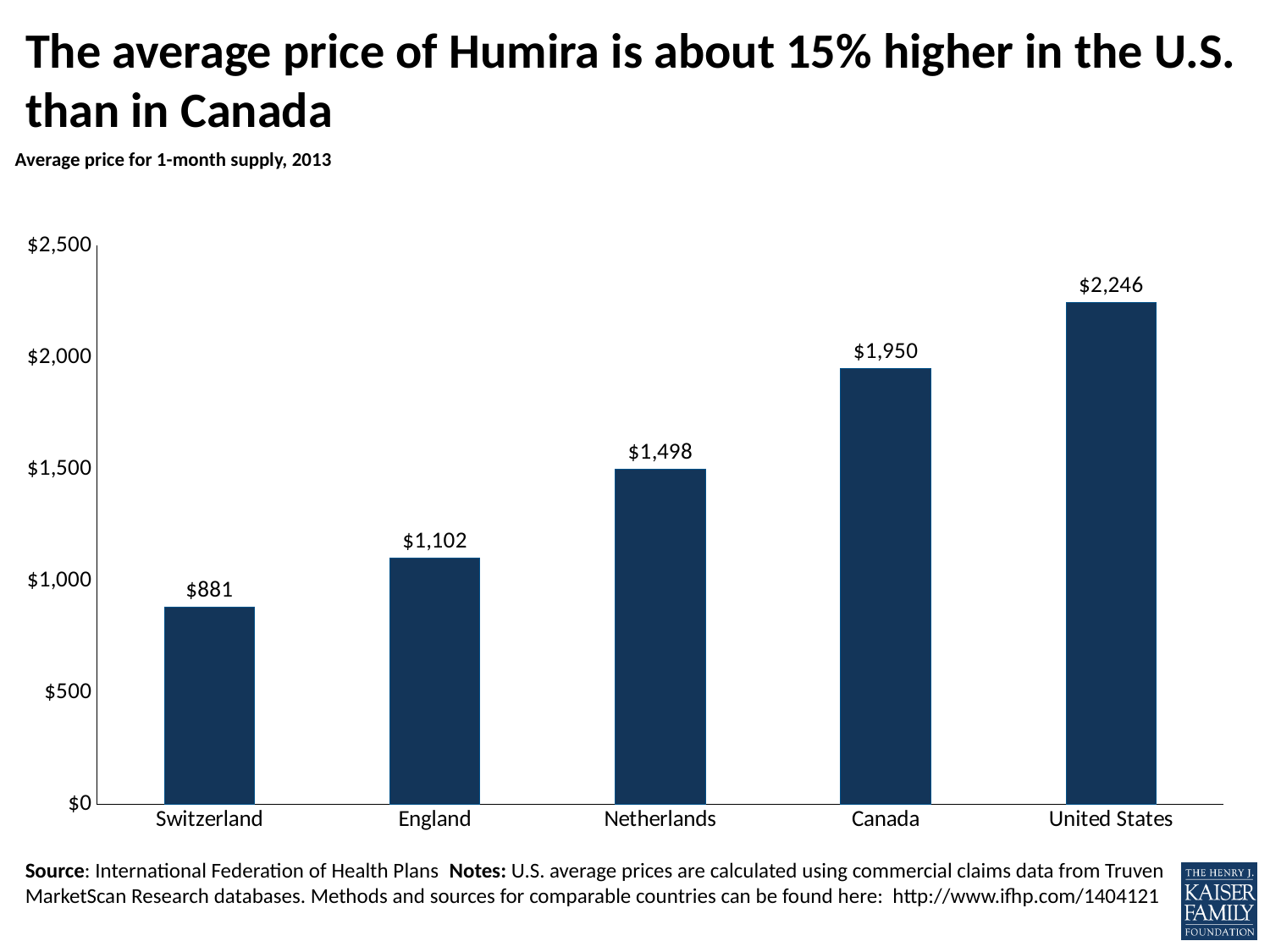
What is the average price of Humira for a 1-month supply in the Netherlands? $1,498 What is the average price of Humira for a 1-month supply in Switzerland? $881 What is the difference between the average price of Humira in England and in Switzerland? $221 What kind of chart is shown on the slide? Bar chart Which has a higher average price of Humira, the Netherlands or England? Netherlands Is the average price of Humira in Canada greater or less than $2,000? less What is the difference between the average price of Humira in the United States and in Canada? $296 Do the average prices rise or fall moving from Switzerland to the United States along the x axis? Rise How many countries are shown in the chart? 5 Which country has the lowest average price of Humira? Switzerland What is the average price of Humira for a 1-month supply in Canada? $1,950 Which country has the highest average price of Humira? United States